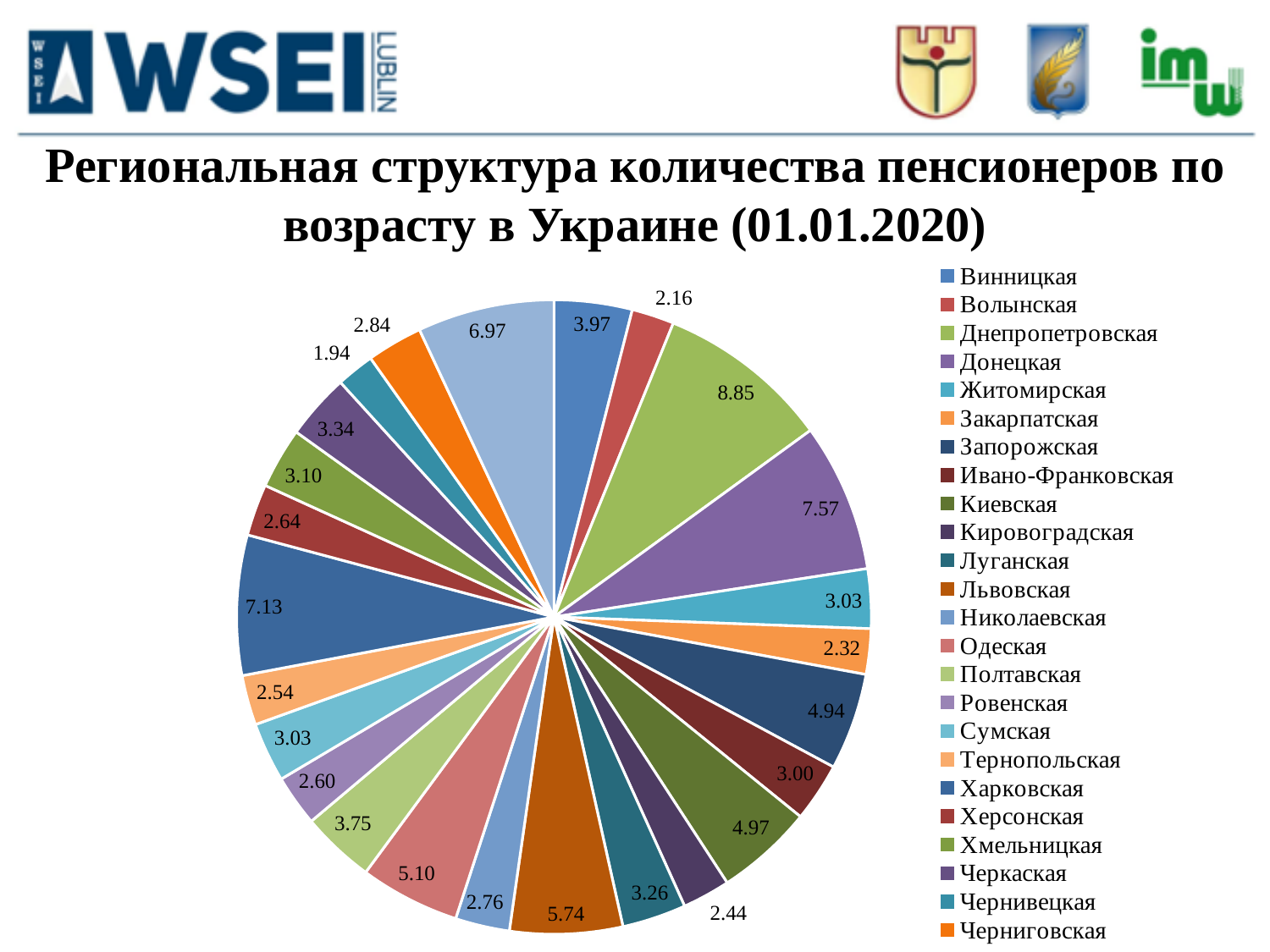
What is the value shown for Харковская? 7.13 What kind of chart is shown on the slide? pie chart What is the value shown for Чернивецкая? 1.94 What is the difference between the values for Запорожская and Закарпатская? 2.62 Which is larger, the value for Донецкая or the value for Харковская? Донецкая What is the value shown for Львовская? 5.74 What is the value shown for Одеская? 5.10 Which region has the largest slice of the pie? Днепропетровская What is the title of the chart on the slide? Региональная структура количества пенсионеров по возрасту в Украине (01.01.2020) Which region has the smallest slice of the pie? Чернивецкая What is the value shown for Днепропетровская? 8.85 What is the difference between the values for Днепропетровская and Донецкая? 1.28